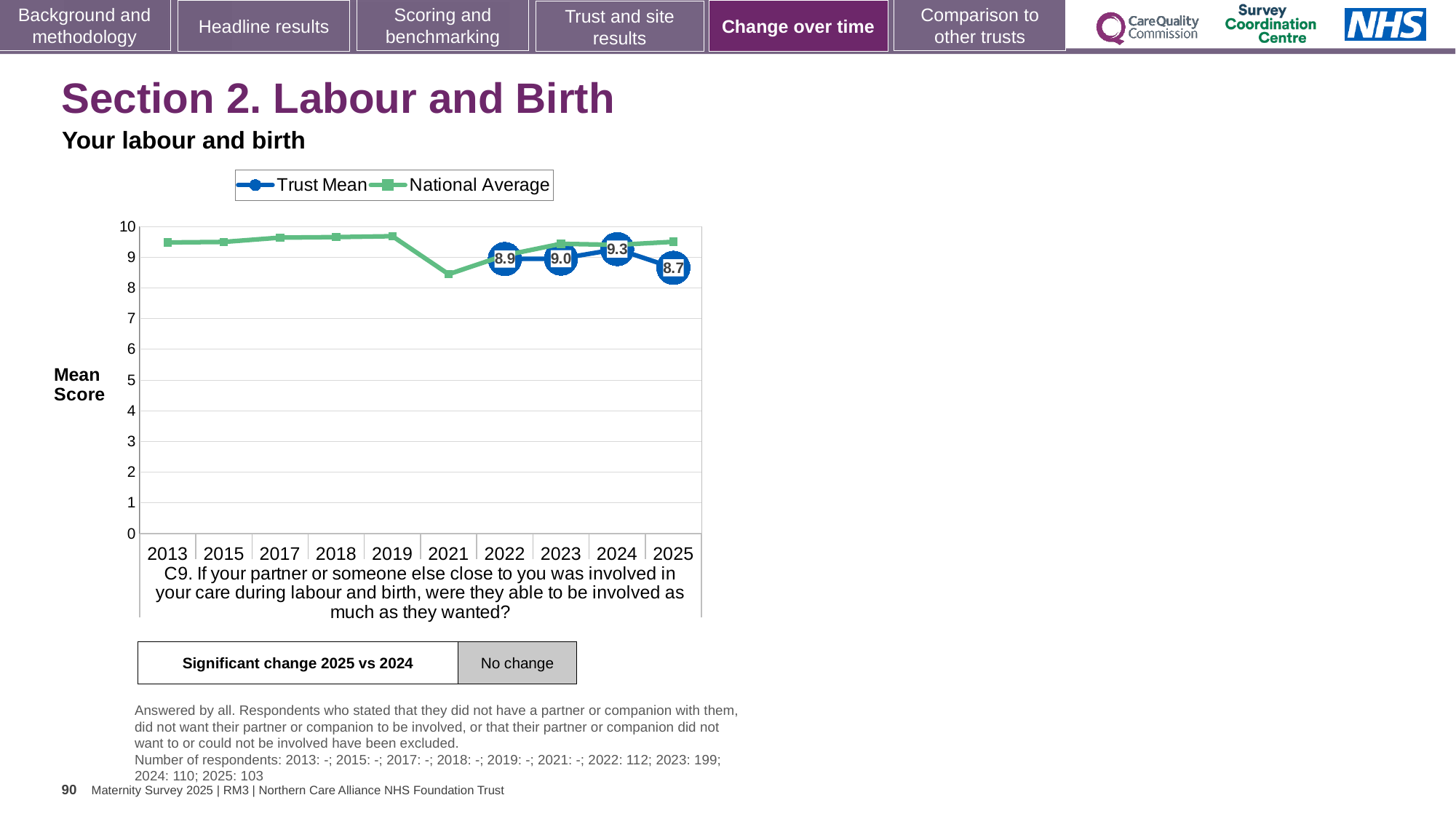
In which year is the Trust Mean lowest? 2025 What is the Trust Mean value for 2024? 9.3 Is the National Average value for 2021 greater or less than 9? less How many years are shown on the x axis? 10 What is the Trust Mean value for 2022? 8.9 Which year has the larger Trust Mean, 2022 or 2023? 2023 Does the Trust Mean rise or fall from 2022 to 2024? rise What is the Trust Mean value for 2025? 8.7 What is the difference between the Trust Mean in 2024 and in 2025? 0.6 What kind of chart is shown on the slide? line chart How many series does the legend list? 2 In which year is the Trust Mean highest? 2024